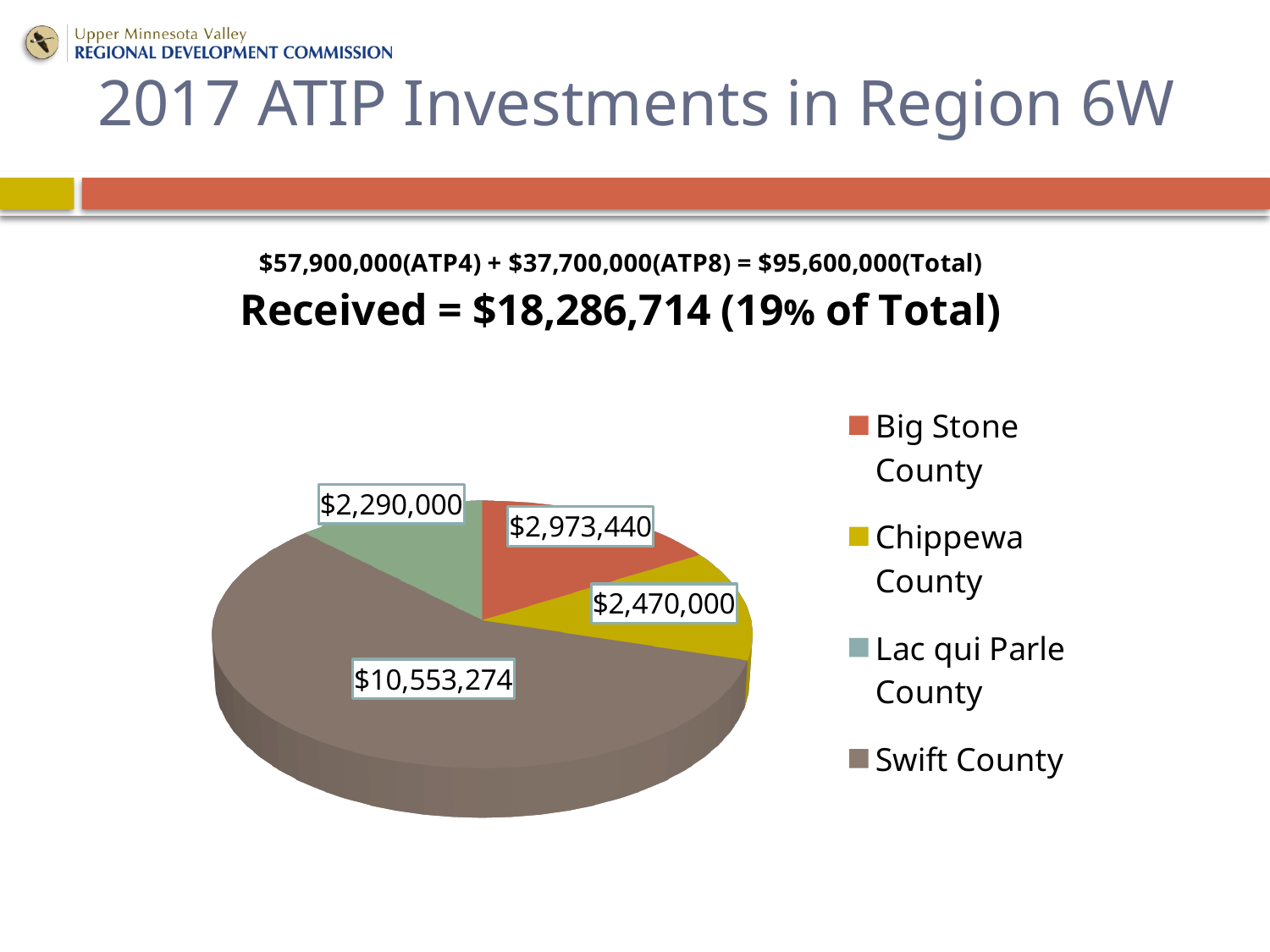
What colour is the slice for Swift County? Brown What is the value shown for Swift County? $10,553,274 What type of chart is shown on the slide? Pie chart How many counties are shown in the pie chart? 4 Which county has the largest slice of the pie? Swift County What is the value shown for Big Stone County? $2,973,440 What is the value shown for Chippewa County? $2,470,000 What is the difference between the values for Swift County and Big Stone County? $7,579,834